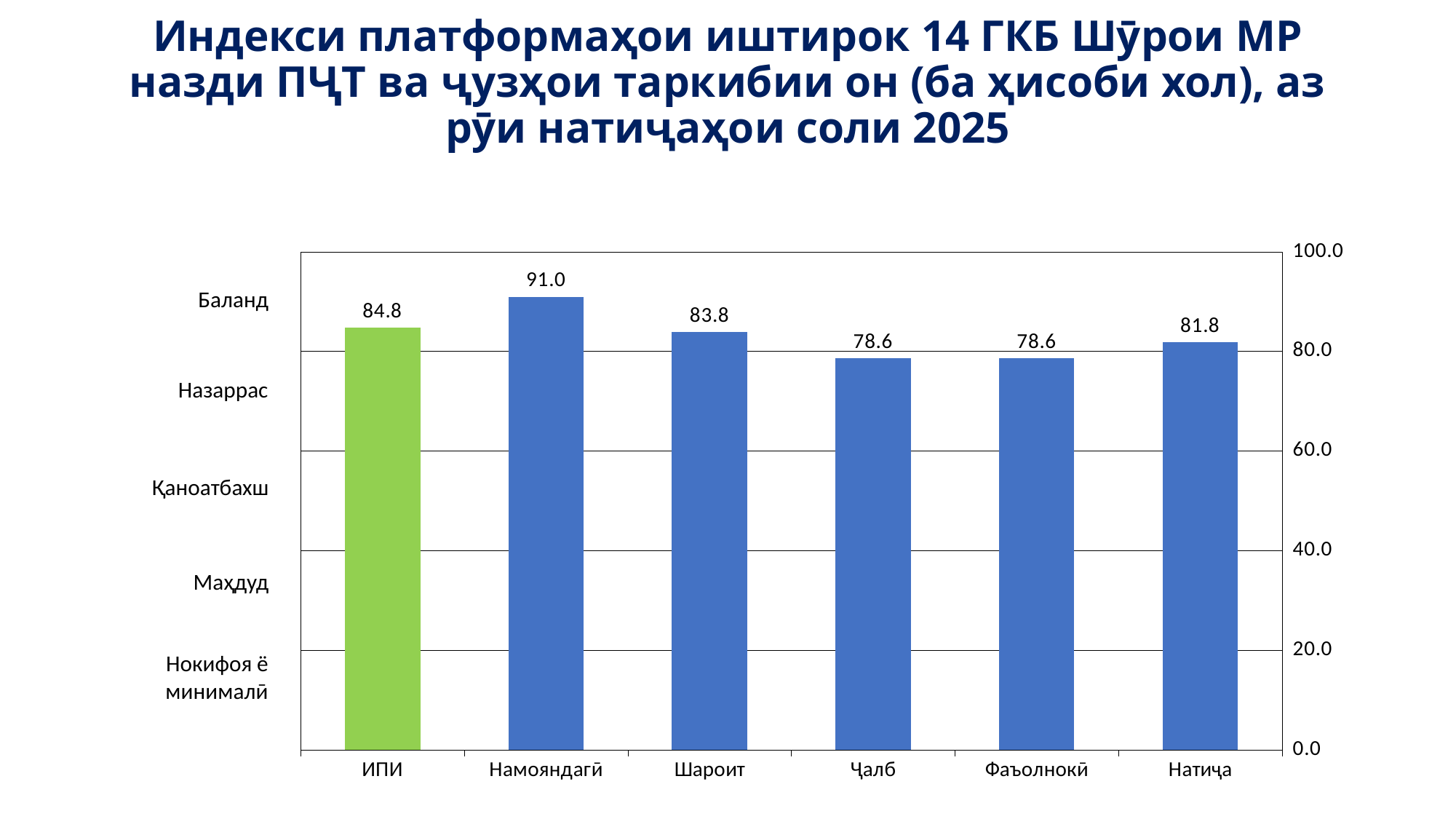
Which is larger, the value for Шароит or the value for Натиҷа? Шароит What is the value for Натиҷа? 81.8 Which bar is coloured green rather than blue? ИПИ What is the difference between the values for Шароит and Ҷалб? 5.2 Which category has the highest value? Намояндагӣ What is the value for ИПИ? 84.8 What is the difference between the values for Намояндагӣ and ИПИ? 6.2 What is the value for Намояндагӣ? 91.0 What kind of chart is shown on the slide? bar chart How many categories are shown on the x axis? 6 What is the value for Шароит? 83.8 Is the value for Ҷалб greater or less than 80.0? less